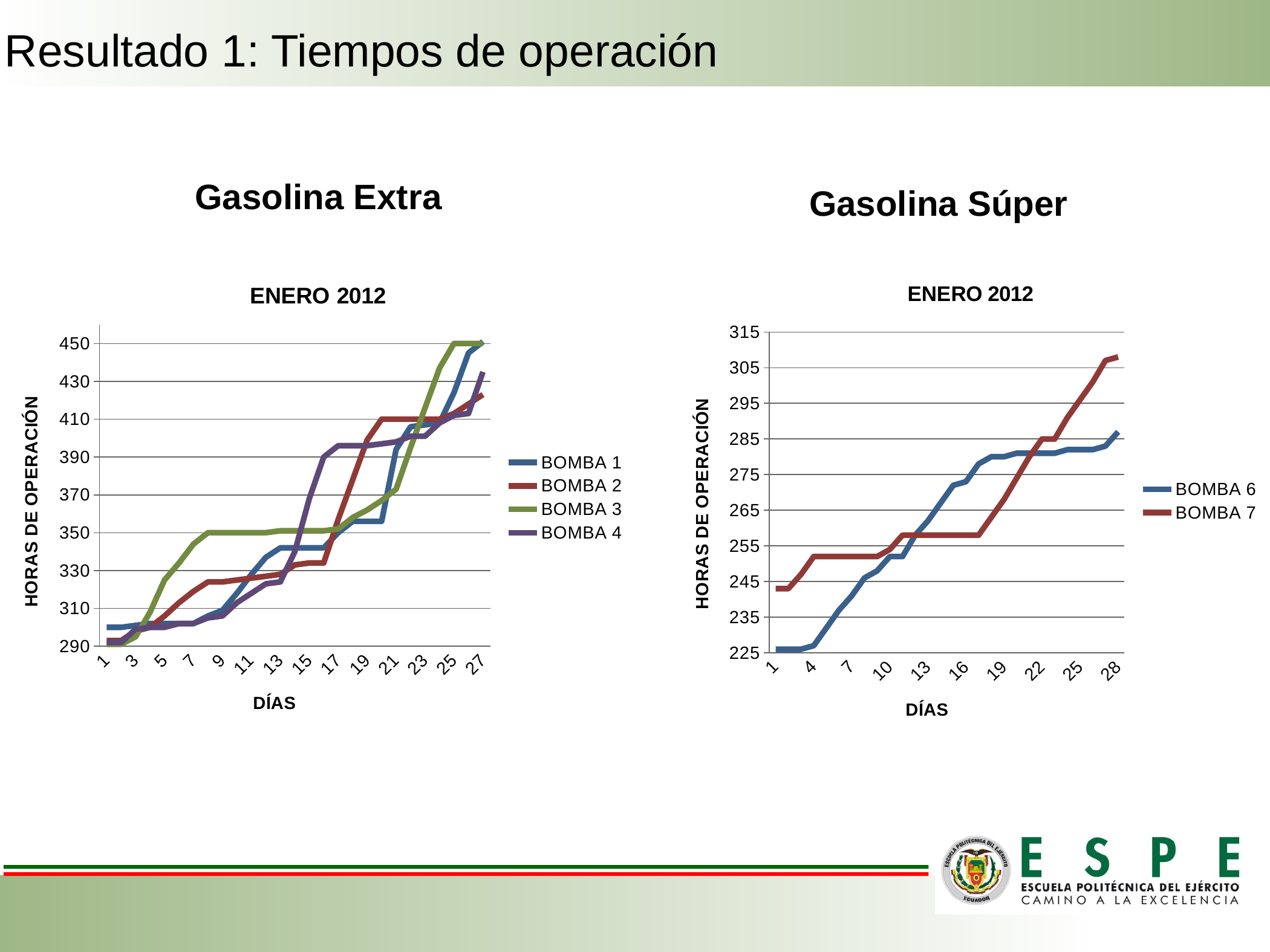
In the Gasolina Extra chart, do the values for BOMBA 1 rise or fall as the days increase? rise In the Gasolina Súper chart, is the value for BOMBA 6 on day 1 greater or less than 235? less What subtitle appears above the plot area of the Gasolina Extra chart? ENERO 2012 In the Gasolina Súper chart, which series has the higher value on day 28, BOMBA 6 or BOMBA 7? BOMBA 7 In the Gasolina Súper chart, do the values for BOMBA 7 rise or fall as the days increase? rise In the Gasolina Extra chart, which series has the higher value on day 7, BOMBA 3 or BOMBA 4? BOMBA 3 What type of chart is the Gasolina Extra chart? line chart How many series does the legend of the Gasolina Extra chart list? 4 In the Gasolina Súper chart, is the value for BOMBA 7 on day 28 greater or less than 305? greater In the Gasolina Extra chart, is the value for BOMBA 2 on day 27 greater or less than 430? less What is the y-axis label of the Gasolina Súper chart? HORAS DE OPERACIÓN How many series does the legend of the Gasolina Súper chart list? 2